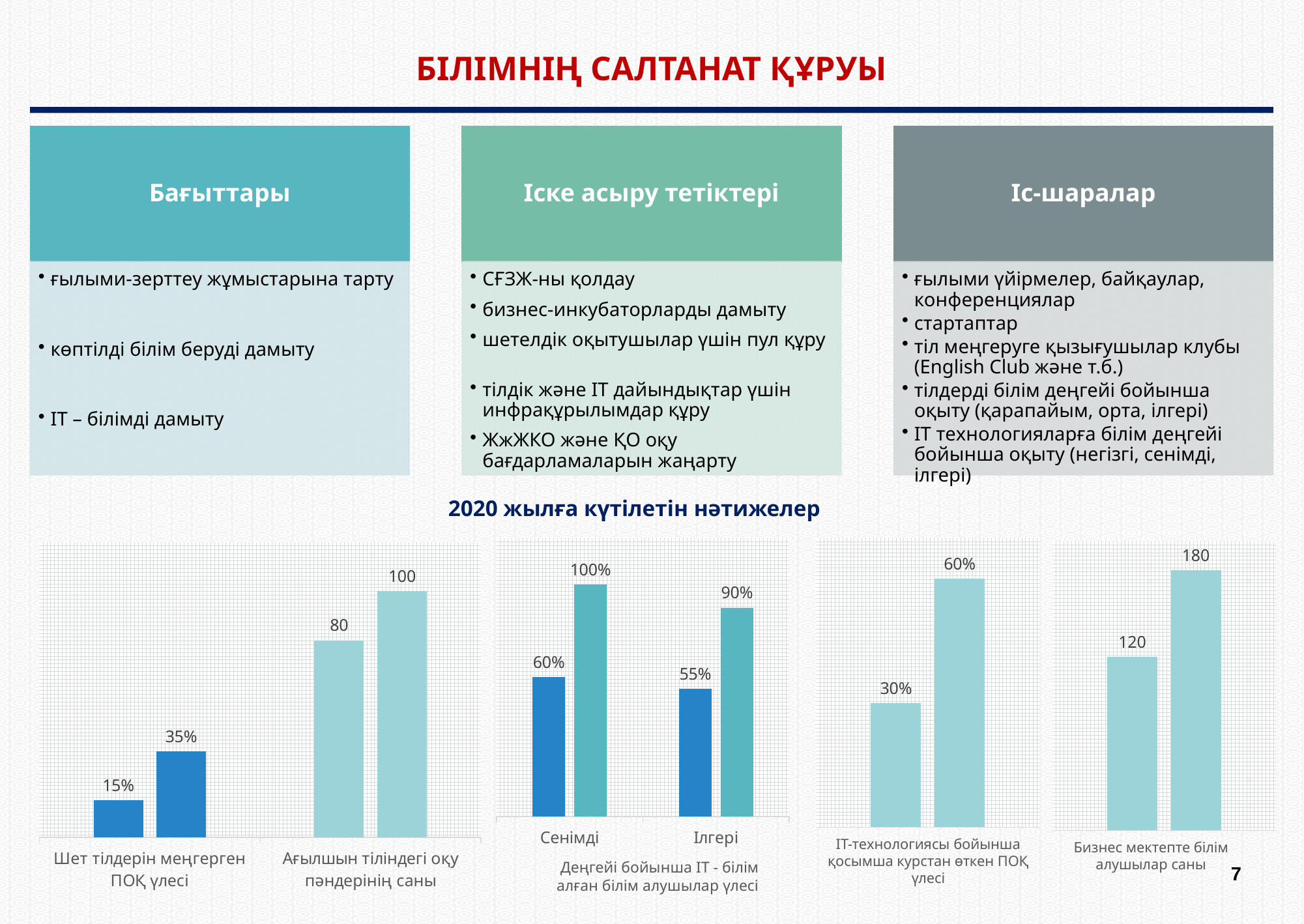
In the chart titled "Деңгейі бойынша IT - білім алған білім алушылар үлесі", what is the value of the right bar for Ілгері? 90% In the chart titled "IT-технологиясы бойынша қосымша курстан өткен ПОҚ үлесі", what is the difference between the right bar and the left bar? 30% In the chart titled "Шет тілдерін меңгерген ПОҚ үлесі", what is the value of the right bar? 35% In the chart titled "Бизнес мектепте білім алушылар саны", what is the value of the right bar? 180 In the chart titled "Бизнес мектепте білім алушылар саны", what is the value of the smaller bar? 120 In the chart titled "Шет тілдерін меңгерген ПОҚ үлесі", what is the value of the left bar? 15% In the chart titled "Деңгейі бойынша IT - білім алған білім алушылар үлесі", which is larger: the left bar for Сенімді or the left bar for Ілгері? Сенімді In the chart titled "Ағылшын тіліндегі оқу пәндерінің саны", what is the value of the taller bar? 100 In the chart titled "Деңгейі бойынша IT - білім алған білім алушылар үлесі", how many categories are shown on the x axis? 2 What type of chart is the chart titled "Бизнес мектепте білім алушылар саны"? Bar chart In the chart titled "Ағылшын тіліндегі оқу пәндерінің саны", what is the difference between the right bar and the left bar? 20 In the chart titled "Деңгейі бойынша IT - білім алған білім алушылар үлесі", what is the value of the left bar for Сенімді? 60%